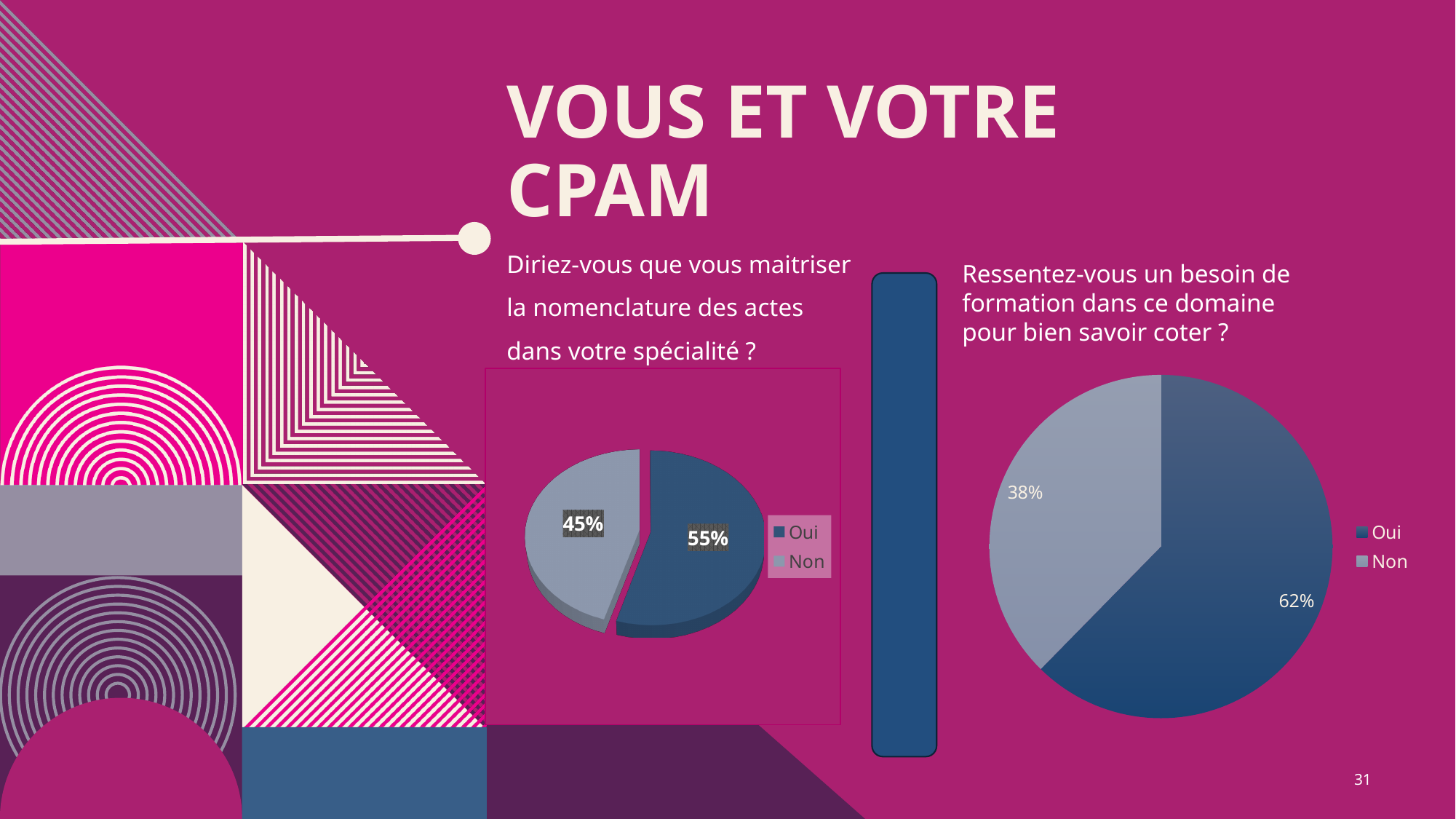
In the right pie chart ("Ressentez-vous un besoin de formation dans ce domaine pour bien savoir coter ?"), what share is labelled for Non? 38% In the left pie chart, which slice is the largest? Oui In the right pie chart ("Ressentez-vous un besoin de formation dans ce domaine pour bien savoir coter ?"), what share is labelled for Oui? 62% In the right pie chart, what is the difference in percentage points between Oui and Non? 24 In the left pie chart ("Diriez-vous que vous maitriser la nomenclature des actes dans votre spécialité ?"), what share is labelled for Non? 45% In the left pie chart ("Diriez-vous que vous maitriser la nomenclature des actes dans votre spécialité ?"), what share is labelled for Oui? 55% How many entries does the legend of the right pie chart list? 2 How many slices does the left pie chart have? 2 Is the Oui share larger in the left pie chart or in the right pie chart? Right pie chart In the left pie chart, what is the difference in percentage points between Oui and Non? 10 In the right pie chart, which slice is the smallest? Non What type of chart is used on the right side of the slide? Pie chart